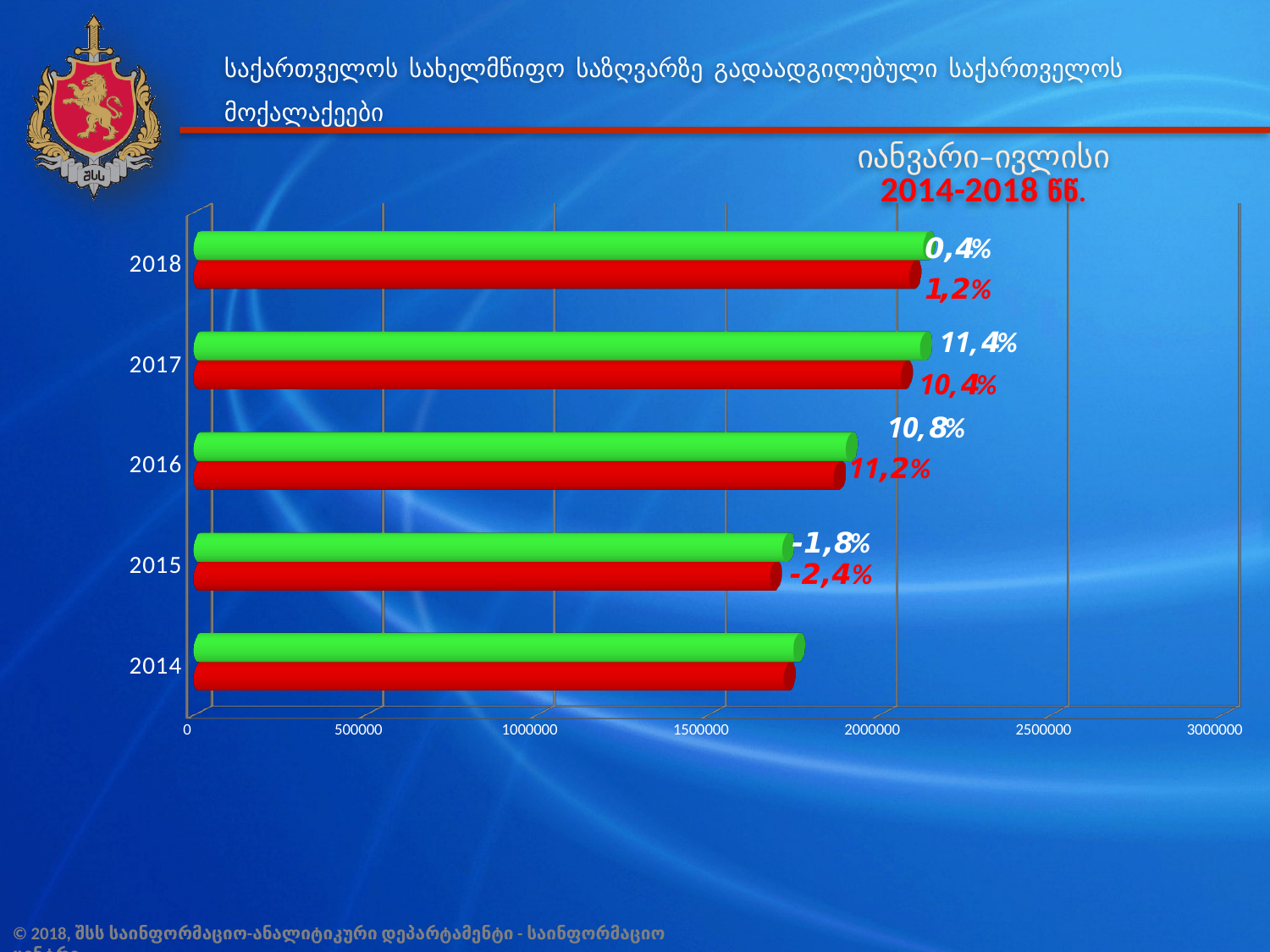
What two colours are used for the bars in the chart? green and red Is the value of the green bar for 2016 greater or less than 2000000? less What percentage label is printed next to the red bar for 2016? 11,2% How many years are shown on the vertical axis of the chart? 5 Which is larger, the green bar for 2017 or the green bar for 2014? 2017 Is the value of the green bar for 2018 greater or less than 2000000? greater What kind of chart is shown on the slide? bar chart Is the value of the red bar for 2014 greater or less than 1500000? greater What percentage label is printed next to the green bar for 2018? 0,4% What percentage label is printed next to the red bar for 2015? -2,4% What percentage label is printed next to the green bar for 2017? 11,4% How many bars are plotted for each year in the chart? 2